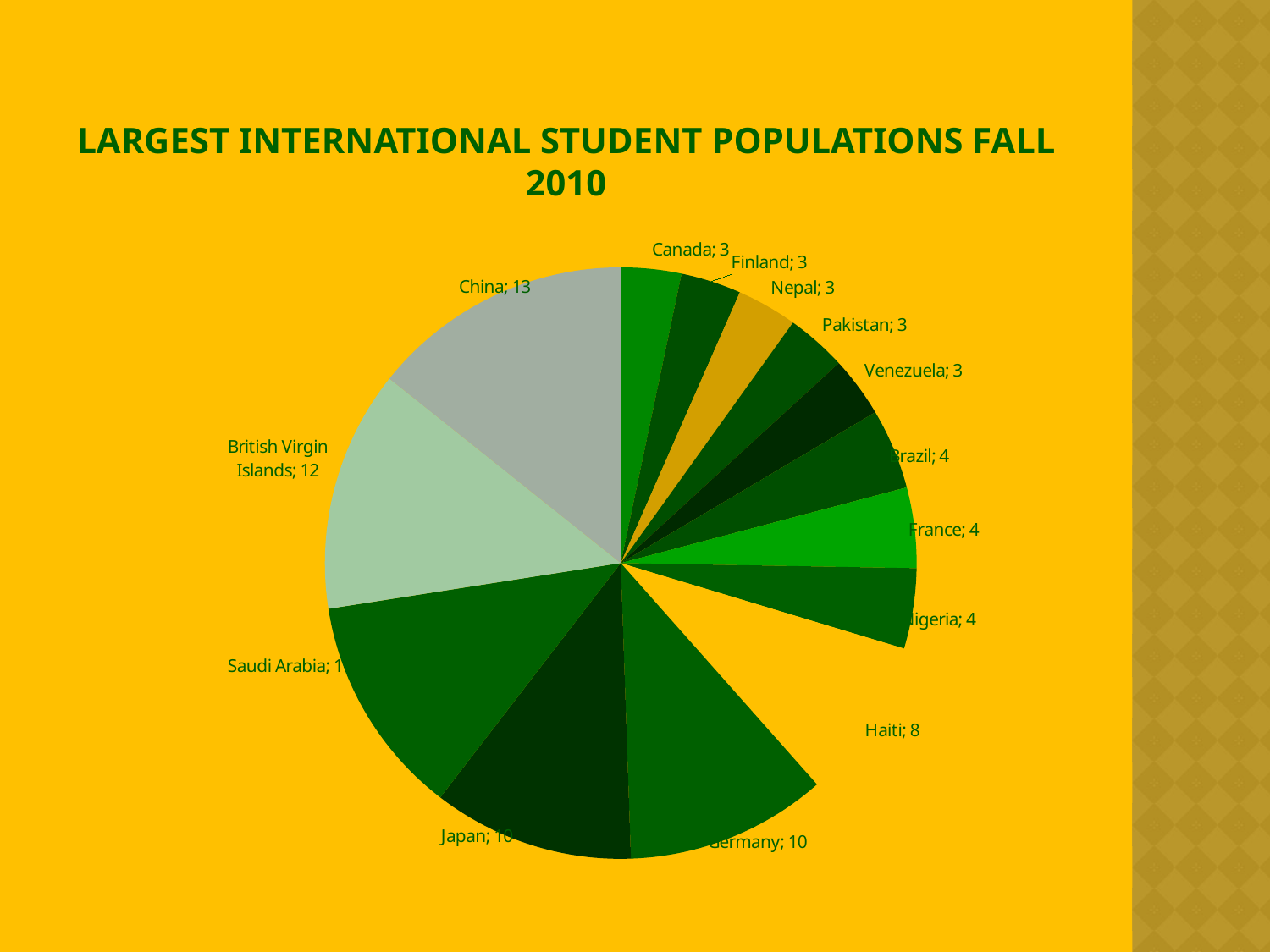
What is the title of the chart? LARGEST INTERNATIONAL STUDENT POPULATIONS FALL 2010 What is the value shown for Canada? 3 What is the difference between the values for Germany and Brazil? 6 What is the difference between the values for China and Haiti? 5 What is the value shown for China? 13 What is the value shown for Germany? 10 What is the value shown for British Virgin Islands? 12 Which has a larger value, China or British Virgin Islands? China What kind of chart is shown on the slide? pie chart What is the value shown for Brazil? 4 Which has a larger value, Haiti or France? Haiti What is the value shown for Haiti? 8